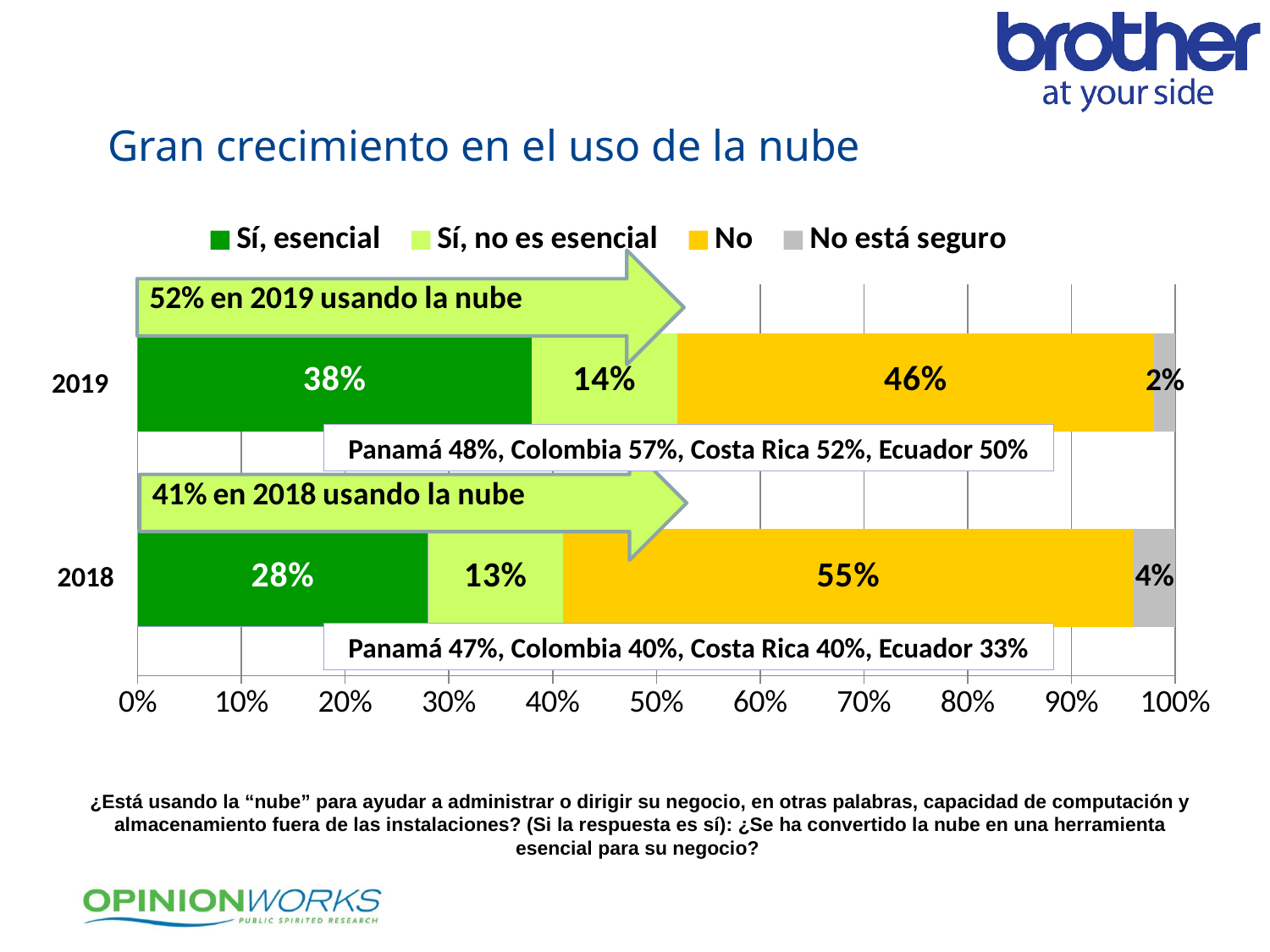
What is the value for "No" in 2018? 55% Which is larger, the "No" value in 2019 or in 2018? 2018 How many years are shown on the chart? 2 Which series has the lowest value in 2019? No está seguro Which series has the highest value in 2018? No What is the title of the slide? Gran crecimiento en el uso de la nube What is the value for "No está seguro" in 2018? 4% How many series does the legend list? 4 What kind of chart is shown on the slide? Stacked bar chart What is the value for "Sí, no es esencial" in 2019? 14% What is the value for "Sí, esencial" in 2019? 38% What is the difference between the "Sí, esencial" values for 2019 and 2018? 10%